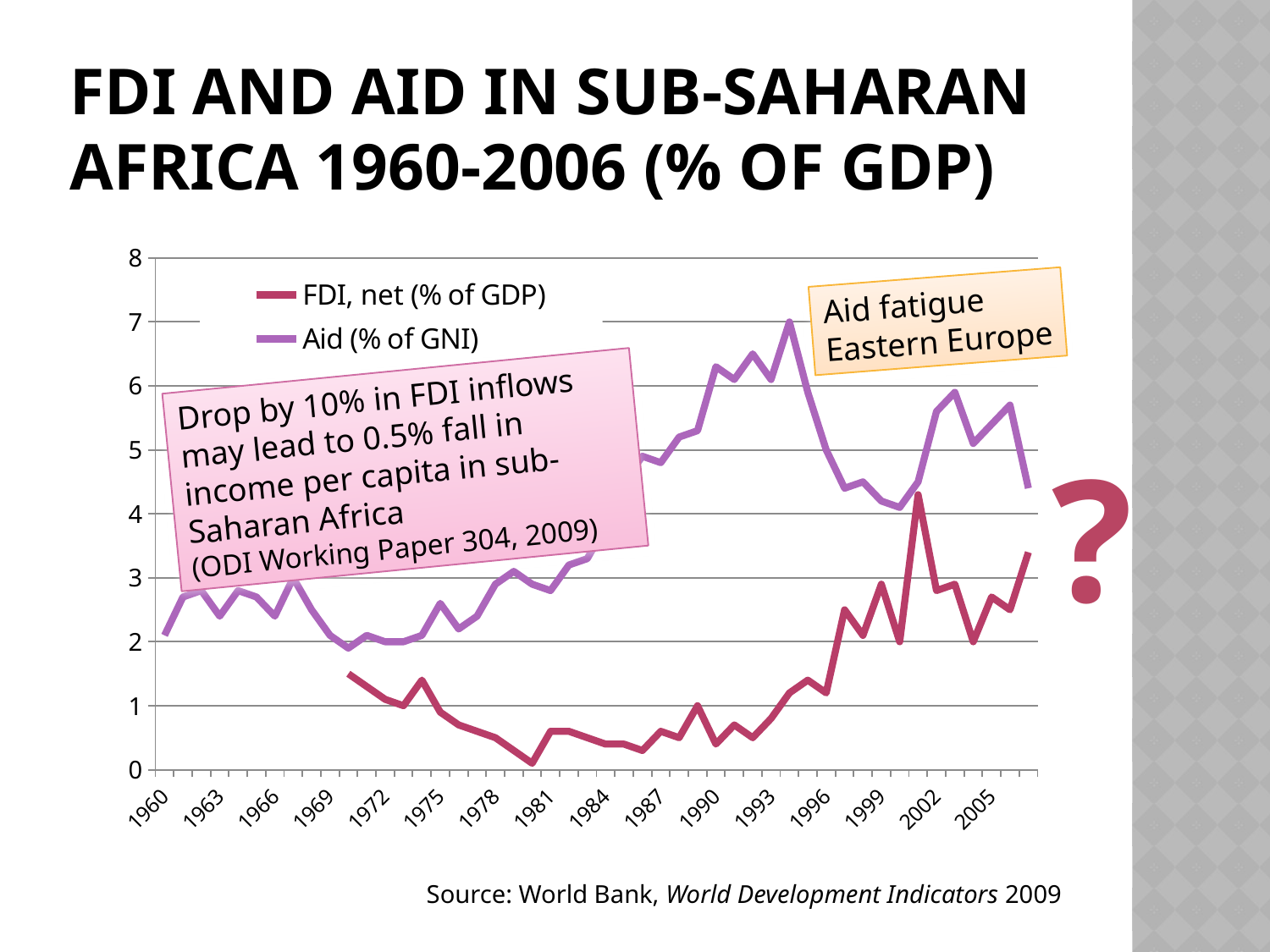
What are the two series named in the legend? FDI, net (% of GDP) and Aid (% of GNI) Is the value for Aid (% of GNI) in 1999 greater or less than 4? greater What is the source cited below the chart? World Bank, World Development Indicators 2009 Does the FDI, net (% of GDP) line rise or fall overall between 1981 and 2001? rise Is the value for Aid (% of GNI) in 1990 greater or less than 6? greater How many series does the legend list? 2 In 1990, which series has the larger value, FDI, net (% of GDP) or Aid (% of GNI)? Aid (% of GNI) What kind of chart is shown on the slide? line chart Is the value for FDI, net (% of GDP) in 1981 greater or less than 1? less